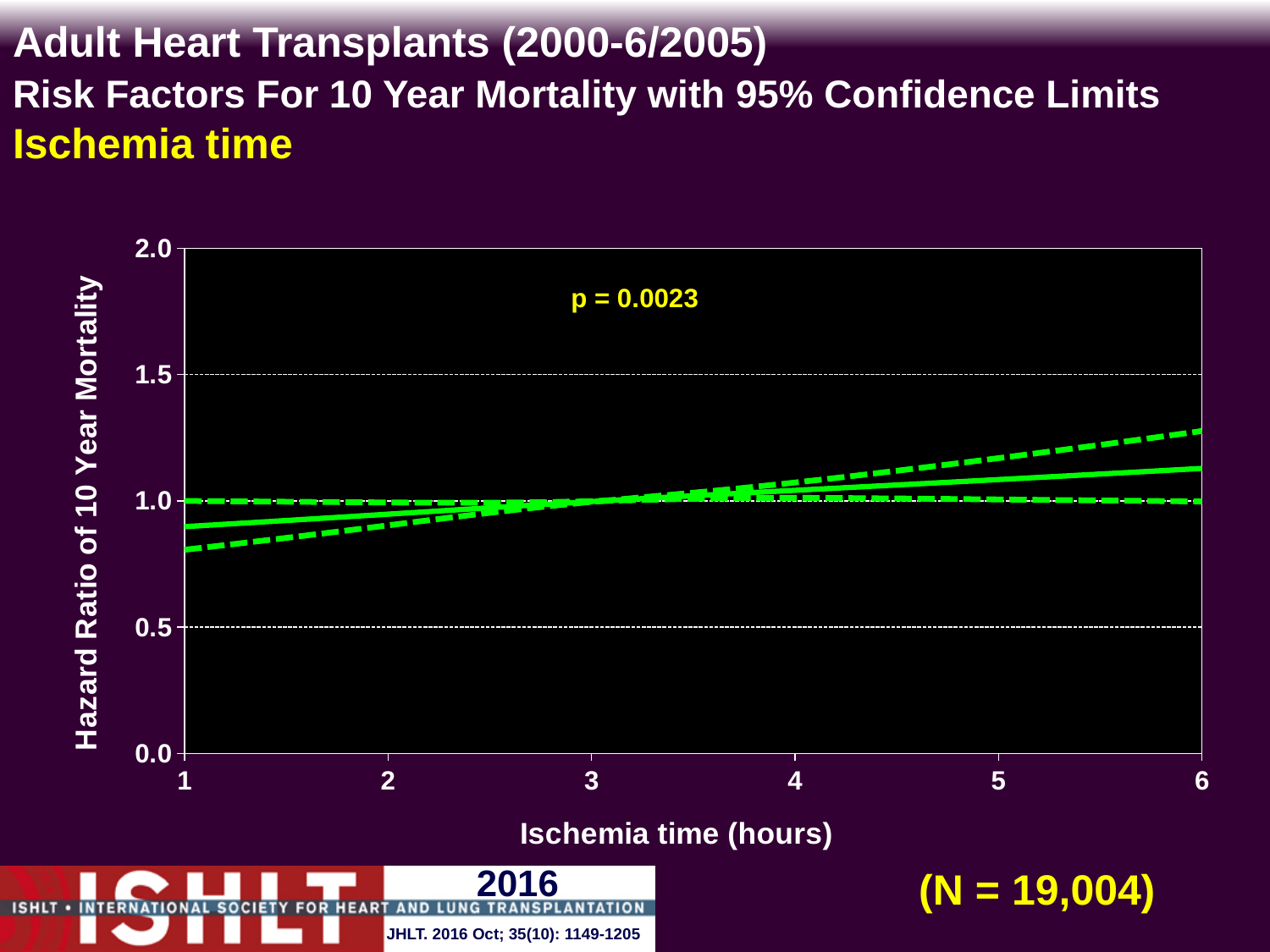
Is the hazard ratio (solid line) at 1 hour of ischemia time greater or less than 1.0? less Is the lower 95% confidence limit (lower dashed line) at 1 hour greater or less than 1.0? less Is the hazard ratio (solid line) at 6 hours greater or less than 1.5? less What kind of chart is shown on the slide? line chart What is the sample size (N) shown on the slide? N = 19,004 Does the solid hazard ratio line rise or fall as ischemia time increases from 1 to 6 hours? rise How many labelled tick marks are on the x axis (ischemia time)? 6 How many lines are plotted on the chart (solid and dashed combined)? 3 What p-value is printed on the chart? p = 0.0023